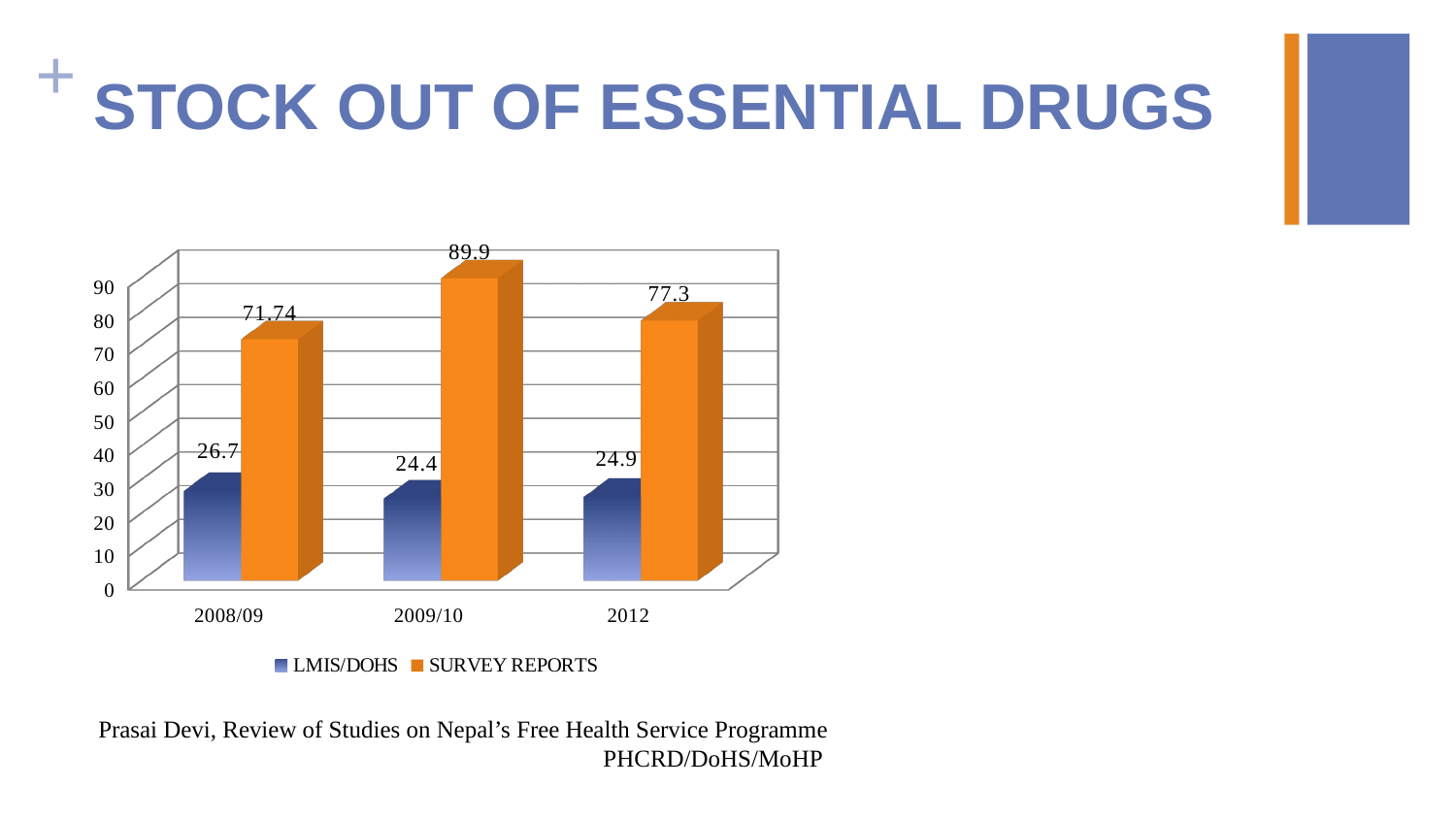
What is the difference between the SURVEY REPORTS and LMIS/DOHS values for 2012? 52.4 Which is larger for 2008/09, the LMIS/DOHS value or the SURVEY REPORTS value? SURVEY REPORTS What kind of chart is shown on the slide? Bar chart What is the SURVEY REPORTS value for 2012? 77.3 What colour are the SURVEY REPORTS bars? Orange Which year has the lowest LMIS/DOHS value? 2009/10 What is the SURVEY REPORTS value for 2009/10? 89.9 What is the difference between the SURVEY REPORTS values for 2009/10 and 2008/09? 18.16 What is the LMIS/DOHS value for 2008/09? 26.7 How many series does the legend list? 2 How many years are shown on the x axis? 3 Which year has the highest SURVEY REPORTS value? 2009/10